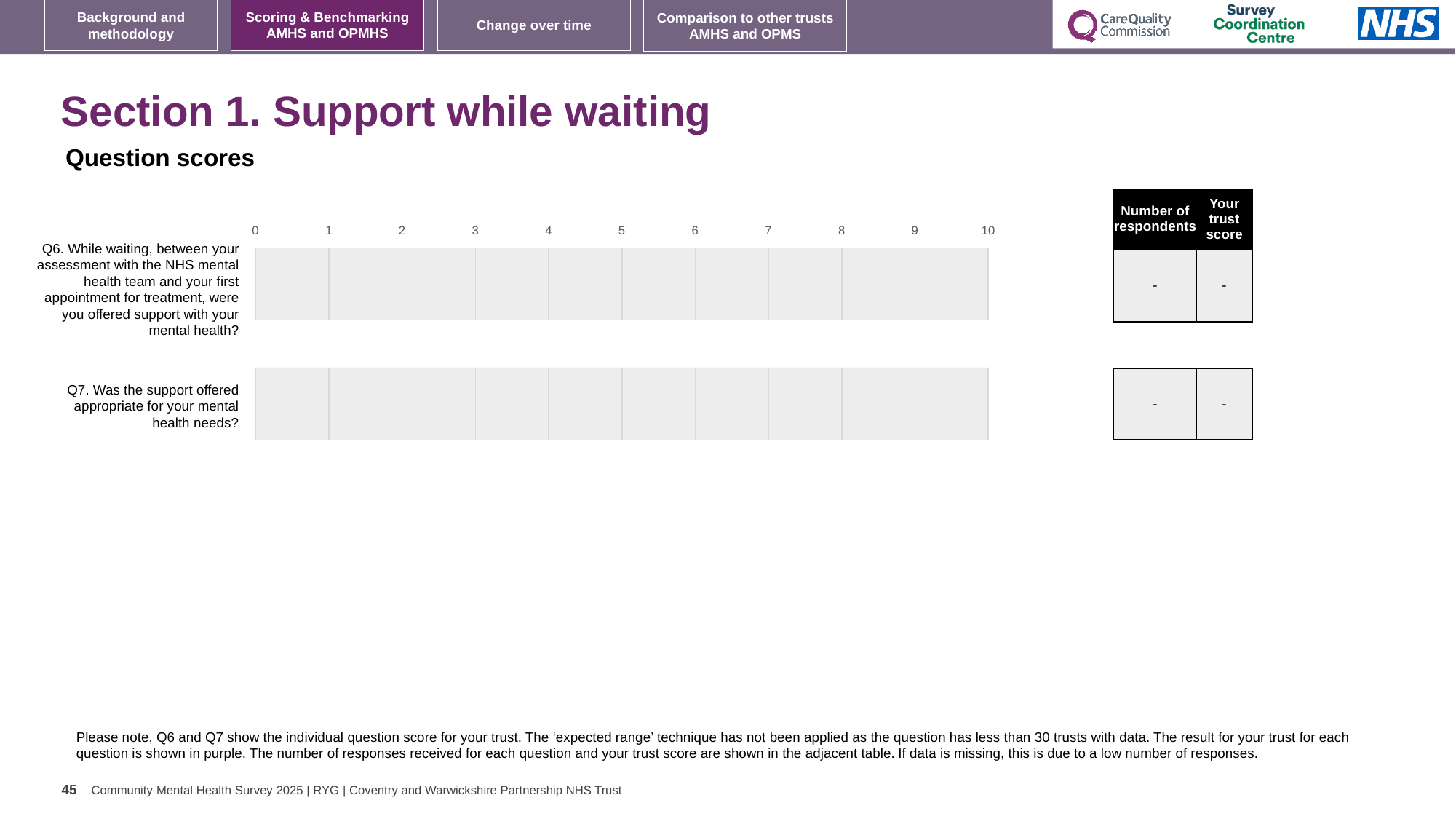
What is the 'Your trust score' shown for Q7 in the adjacent table? - What is the 'Your trust score' shown for Q6 in the adjacent table? - What is the 'Number of respondents' shown for Q7 in the adjacent table? - Are any bars plotted for Q6 or Q7 on the chart? No What is the 'Number of respondents' shown for Q6 in the adjacent table? - How many questions (categories) are listed on the chart? 2 What is the lowest value shown on the chart's horizontal axis? 0 What is the highest value shown on the chart's horizontal axis? 10